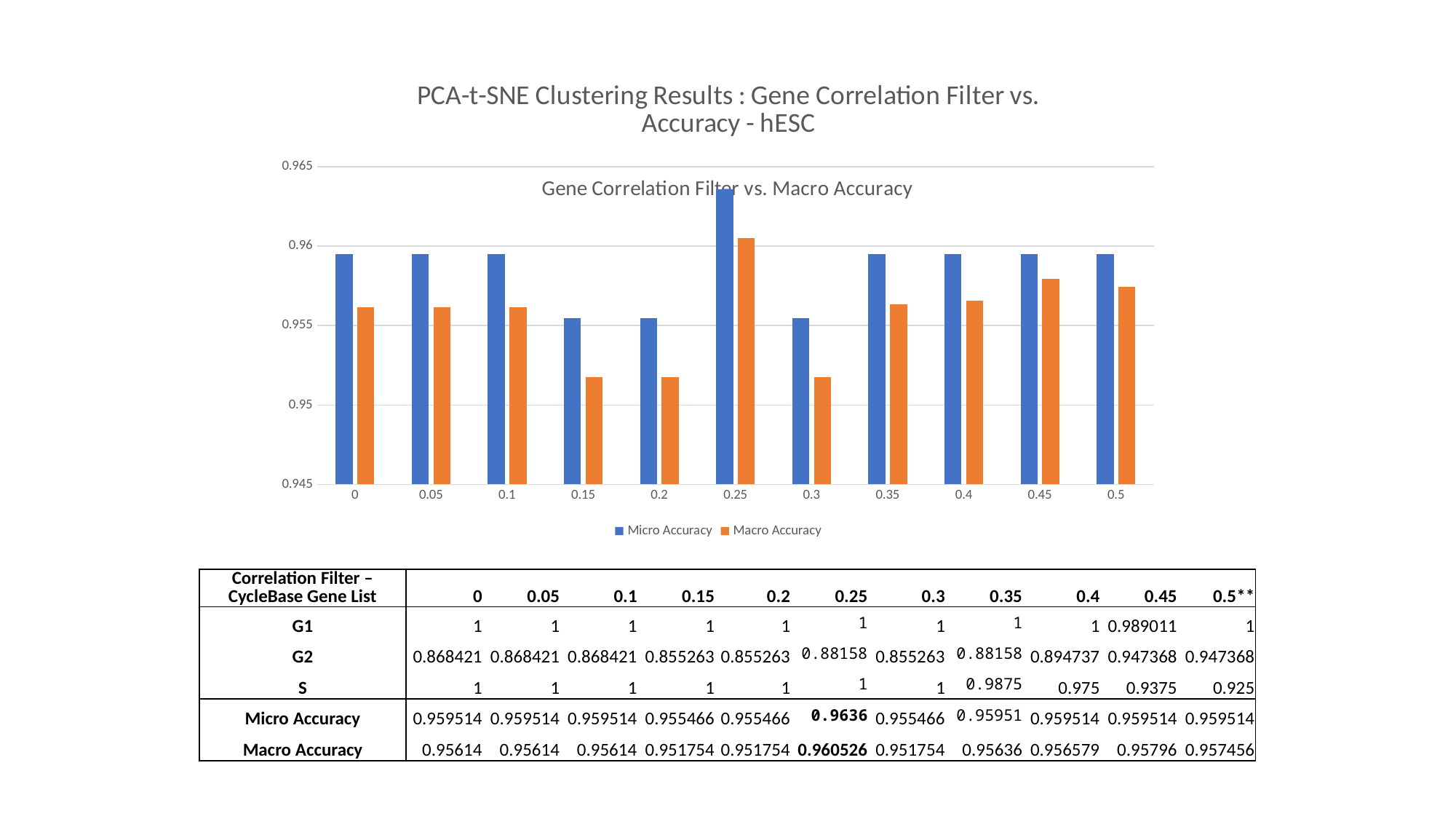
At which correlation filter value is Micro Accuracy highest? 0.25 How many correlation filter values are plotted along the x axis of the chart? 11 What is the difference between the Micro Accuracy at a correlation filter of 0.25 and at a correlation filter of 0? 0.004086 Is the Micro Accuracy at a correlation filter of 0.25 greater or less than 0.96? greater At a correlation filter of 0.4, which is larger, Micro Accuracy or Macro Accuracy? Micro Accuracy What is the Macro Accuracy at a correlation filter of 0.45? 0.95796 Is the Macro Accuracy at a correlation filter of 0.15 greater or less than 0.955? less How many series does the chart legend list? 2 What colour are the Macro Accuracy bars in the chart? Orange At which correlation filter value is Macro Accuracy highest? 0.25 What is the Micro Accuracy at a correlation filter of 0.25? 0.9636 What kind of chart is shown on the slide? Bar chart